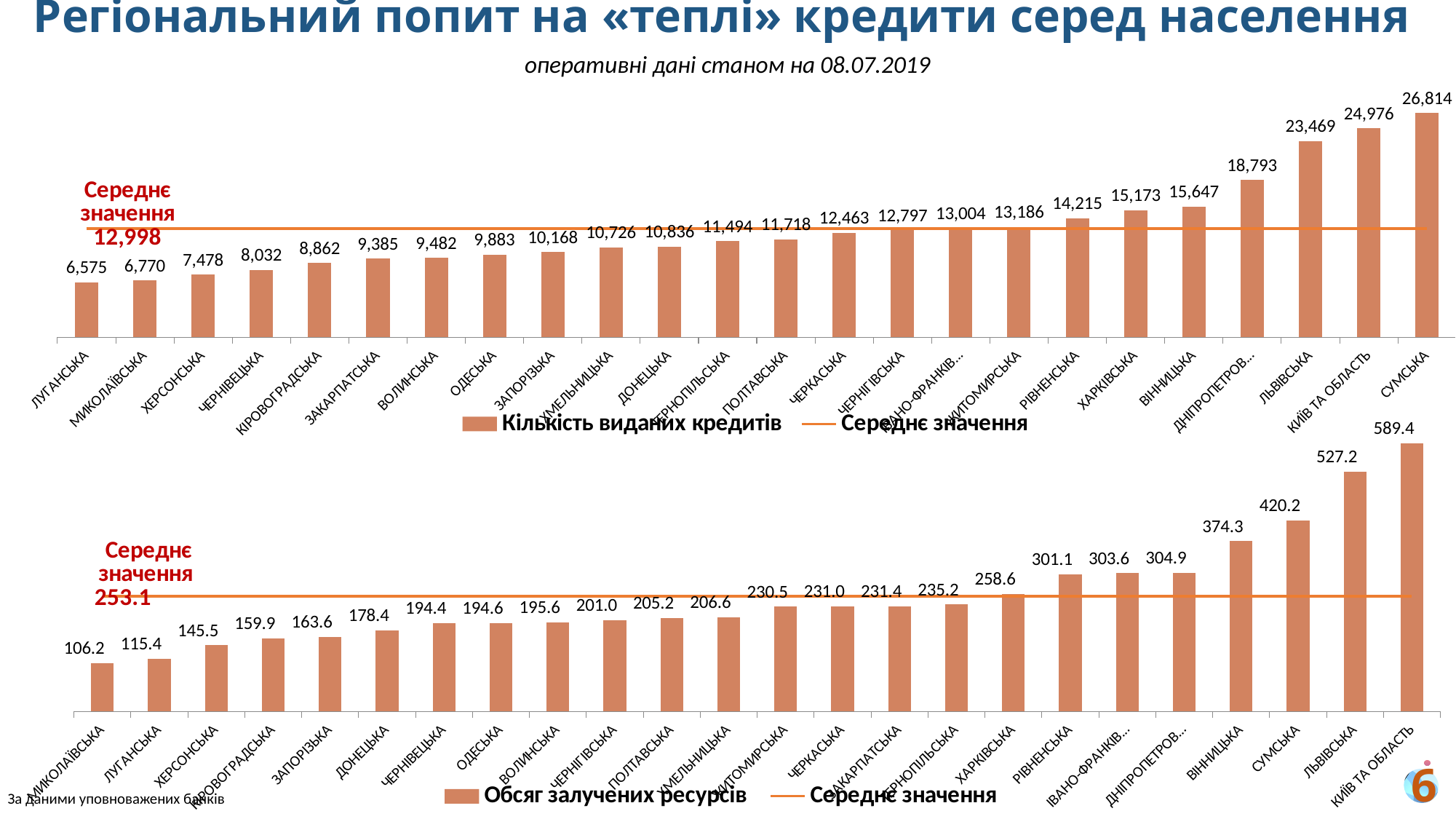
How many entries does the legend of the bottom chart list? 2 What kind of chart is the top chart? bar chart In the bottom chart, which is larger, the value for Вінницька or the value for Рівненська? Вінницька In the top chart, what is the difference between the values for Львівська and Дніпропетровська? 4,676 In the top chart, which region has the lowest value? Луганська In the top chart, how many regions are plotted? 24 In the bottom chart, do the values rise or fall from left to right along the x axis? rise In the bottom chart, which region has the lowest value? Миколаївська In the bottom chart, what is the value for Київ та область? 589.4 In the bottom chart, what is the difference between the values for Львівська and Сумська? 107.0 In the top chart, what is the value for Сумська? 26,814 In the top chart, what is the average value shown by the horizontal line? 12,998